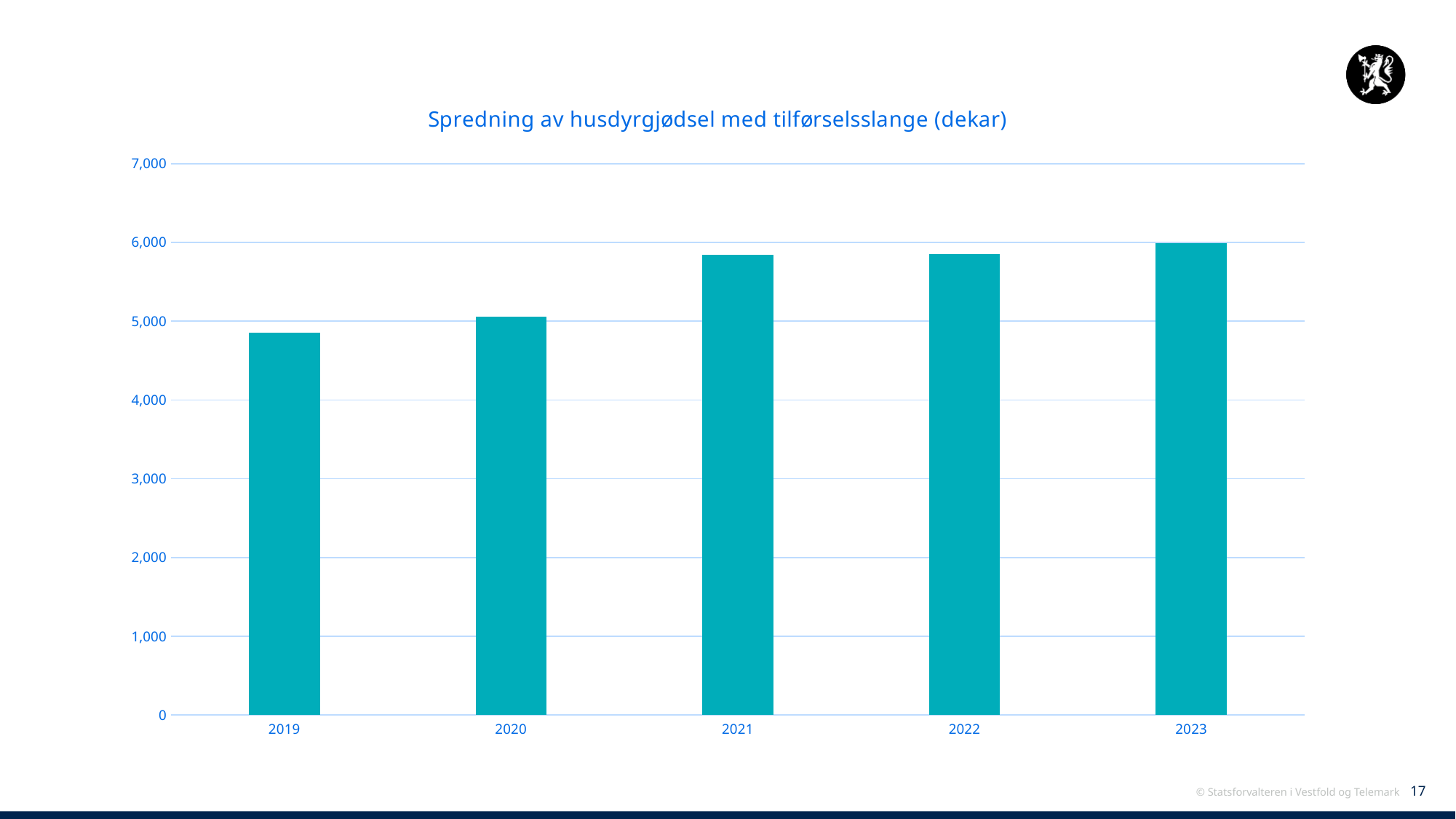
Is the value for 2019 greater or less than 4,000? greater Do the values generally rise or fall from 2019 to 2023? rise Which is larger, the value for 2019 or the value for 2021? 2021 Is the value for 2019 greater or less than 5,000? less Which year has the highest value in the chart? 2023 What kind of chart is shown on the slide? Bar chart Is the value for 2022 greater or less than 6,000? less How many years are shown on the x axis of the chart? 5 Which year has the lowest value in the chart? 2019 What is the title of the chart? Spredning av husdyrgjødsel med tilførselsslange (dekar)